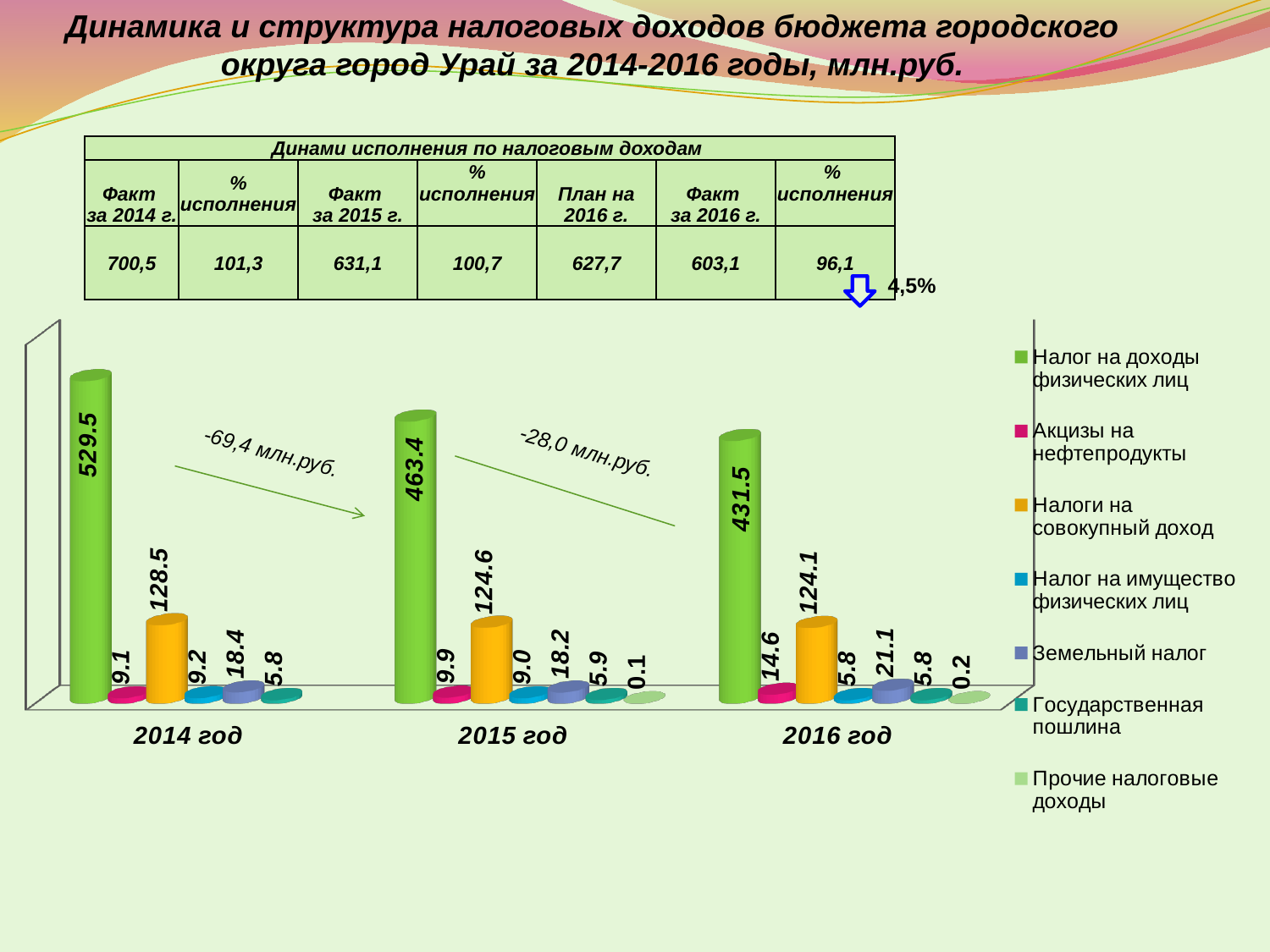
How many year categories are shown on the x axis? 3 What kind of chart is shown on the slide? Bar chart What is the value of Акцизы на нефтепродукты for 2016 год? 14.6 How many series does the legend list? 7 Which is larger: Земельный налог in 2016 год or in 2014 год? 2016 год What is the value of Налоги на совокупный доход for 2016 год? 124.1 What is the value of Налог на доходы физических лиц for 2014 год? 529.5 How does the value of Налог на доходы физических лиц change from 2014 год to 2016 год? It falls Which year has the highest value for Налог на доходы физических лиц? 2014 год What is the value of Земельный налог for 2015 год? 18.2 What is the difference between Налог на доходы физических лиц in 2014 год and 2015 год? 66.1 Which year has the lowest value for Налог на доходы физических лиц? 2016 год